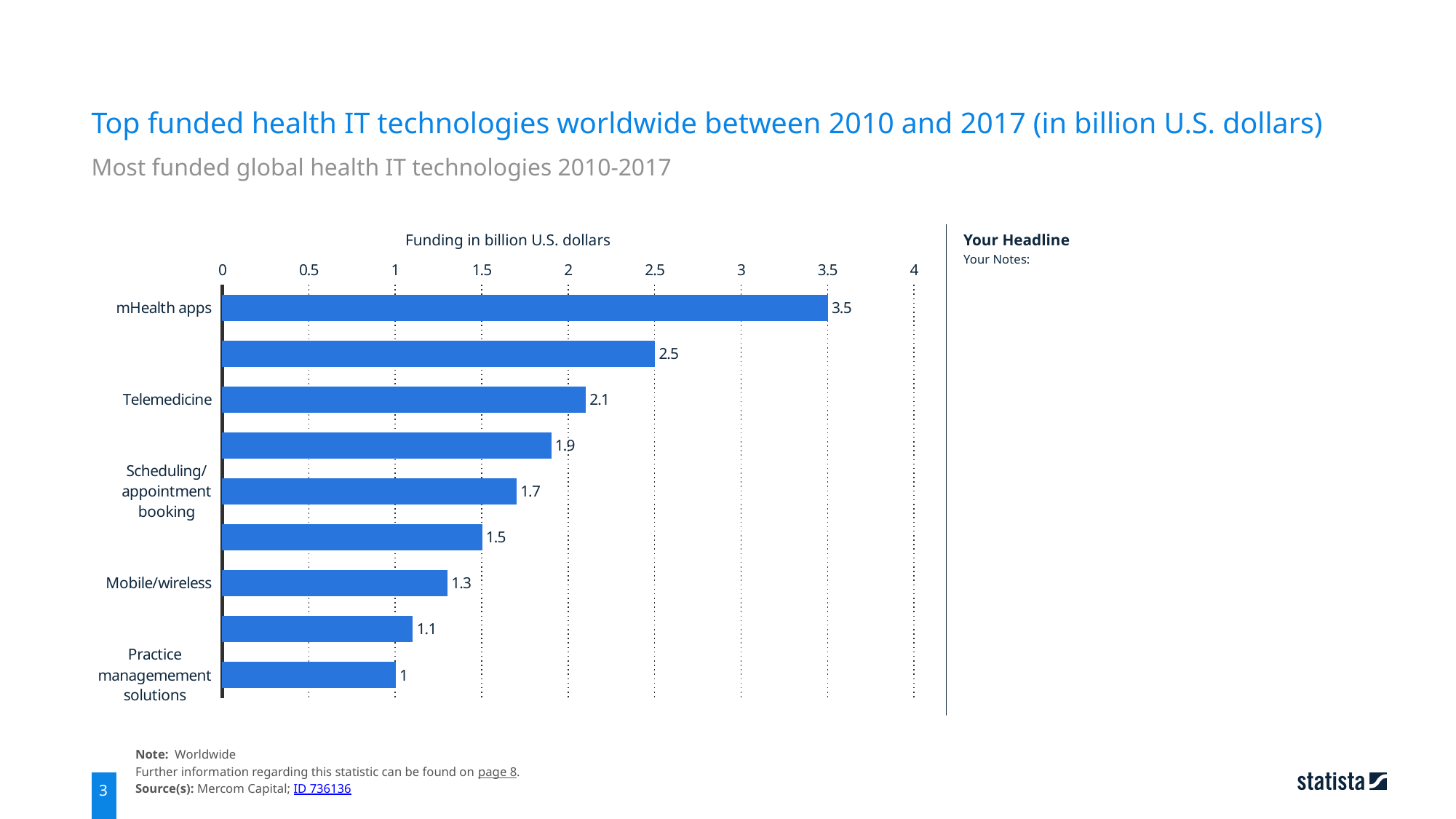
What is the funding value for Telemedicine? 2.1 What is the funding value for mHealth apps? 3.5 Which category has the highest funding? mHealth apps Which category has the lowest funding? Practice management solutions What is the axis title shown above the chart? Funding in billion U.S. dollars How many bars are plotted in the chart? 9 What is the funding value for Practice management solutions? 1 What is the difference in funding between mHealth apps and Telemedicine? 1.4 Which has higher funding, Telemedicine or Mobile/wireless? Telemedicine What kind of chart is shown on the slide? Bar chart What is the funding value for Mobile/wireless? 1.3 What is the funding value for Scheduling/appointment booking? 1.7